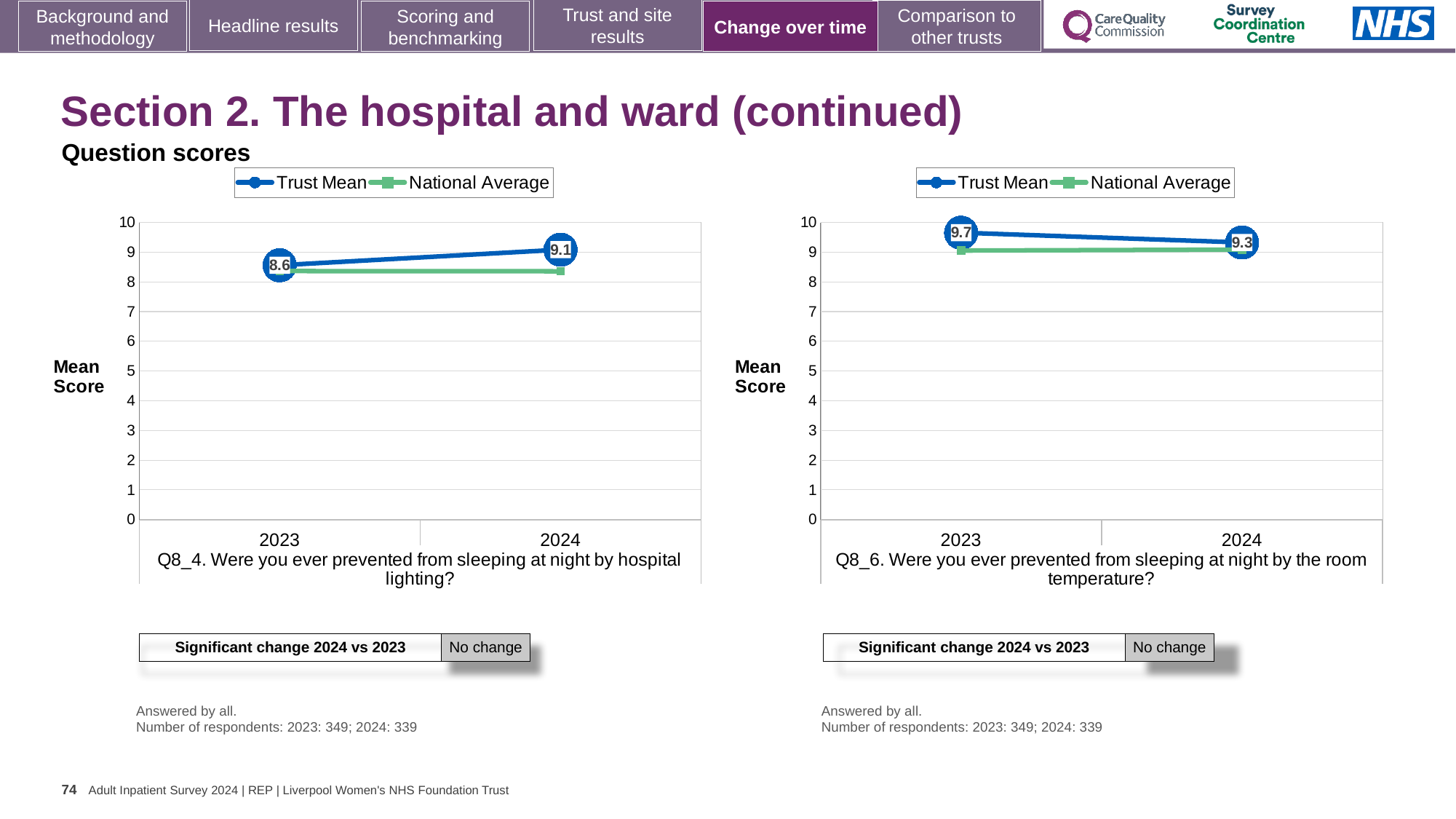
In the Q8_6 chart (room temperature), what is the Trust Mean for 2023? 9.7 In the Q8_6 chart (room temperature), does the Trust Mean rise or fall from 2023 to 2024? fall In the Q8_4 chart (hospital lighting), does the Trust Mean rise or fall from 2023 to 2024? rise How many series does the legend of the Q8_4 chart (hospital lighting) list? 2 In the Q8_6 chart (room temperature), what is the difference between the Trust Mean in 2023 and 2024? 0.4 In the Q8_6 chart (room temperature), what is the Trust Mean for 2024? 9.3 In the Q8_4 chart (hospital lighting), what is the Trust Mean for 2024? 9.1 In the Q8_4 chart (hospital lighting), by how much did the Trust Mean change from 2023 to 2024? 0.5 In the Q8_4 chart (hospital lighting), is the National Average for 2024 greater or less than 9? less In the Q8_6 chart (room temperature), which is larger in 2023: the Trust Mean or the National Average? Trust Mean In the Q8_4 chart (hospital lighting), what is the Trust Mean for 2023? 8.6 What kind of chart is the Q8_6 chart (room temperature)? line chart